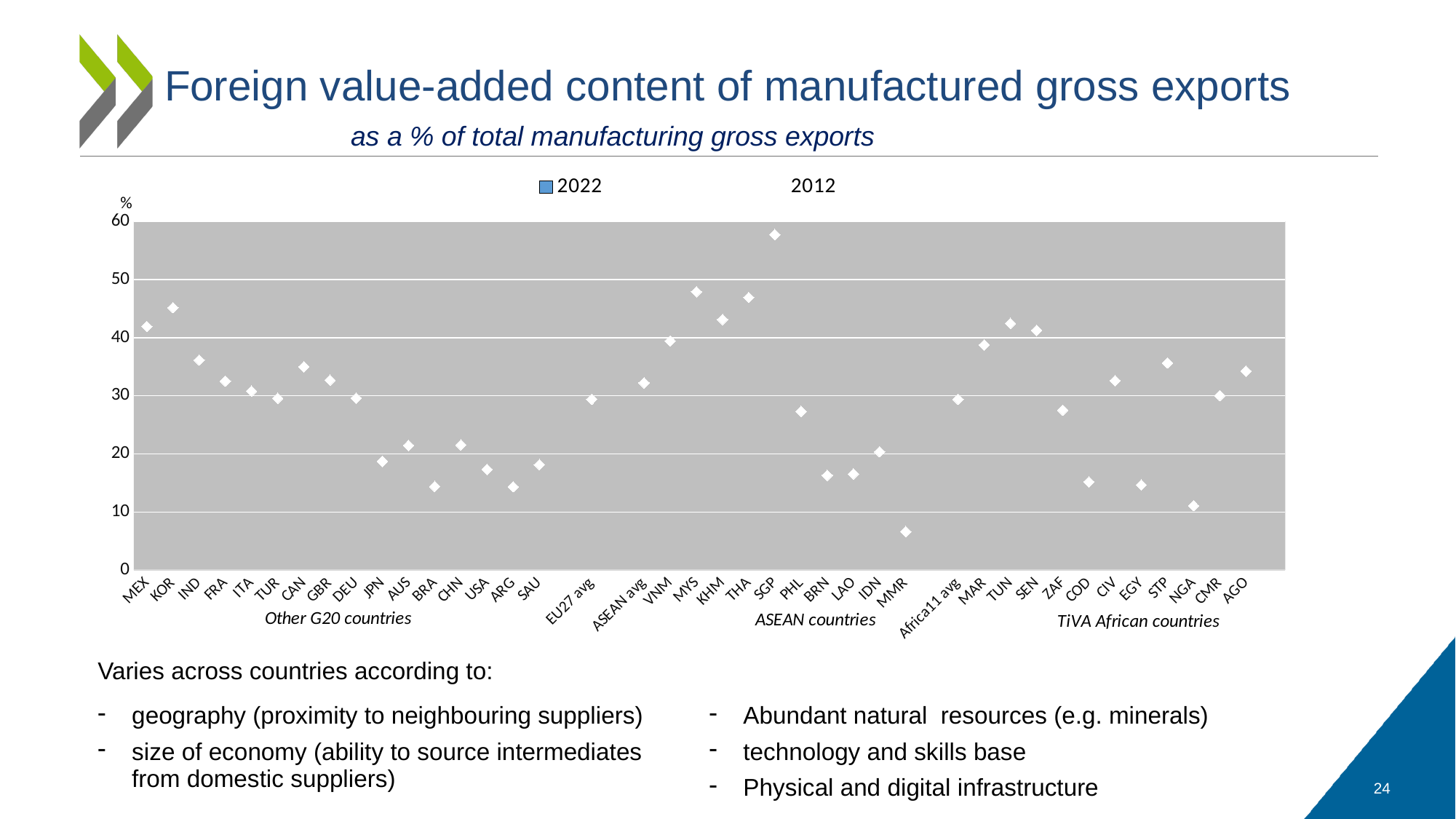
Is the 2012 value for PHL greater or less than 30? less Is the 2012 value for SGP greater or less than 50? greater Is the 2012 value for KOR greater or less than 40? greater How many series does the legend list? 2 Which country has the lowest 2012 value on the chart? MMR Which country has the highest 2012 value on the chart? SGP Which has the larger 2012 value, MYS or PHL? MYS How many categories are shown on the x axis? 40 Which has the larger 2012 value, MAR or NGA? MAR